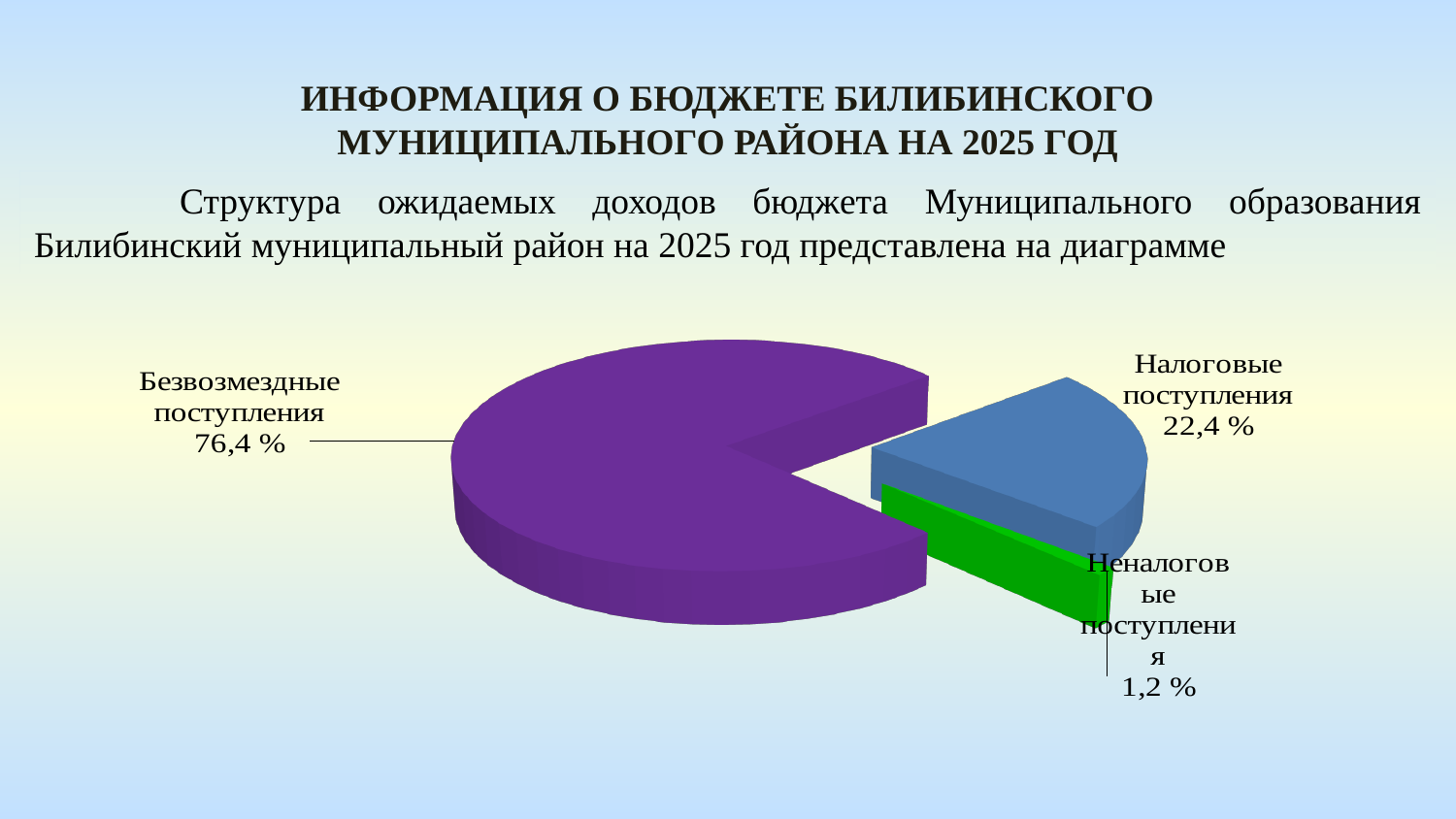
What share of the pie does Безвозмездные поступления have? 76,4 % What is the difference between the shares of Безвозмездные поступления and Налоговые поступления? 54,0 % Which is larger: the share of Налоговые поступления or the share of Неналоговые поступления? Налоговые поступления Which slice of the pie is the largest? Безвозмездные поступления What share of the pie does Налоговые поступления have? 22,4 % What colour is the slice for Неналоговые поступления? Green What share of the pie does Неналоговые поступления have? 1,2 % How many slices does the pie chart have? 3 What is the difference between the shares of Налоговые поступления and Неналоговые поступления? 21,2 % What kind of chart is shown on the slide? Pie chart What colour is the slice for Безвозмездные поступления? Purple Which slice of the pie is the smallest? Неналоговые поступления